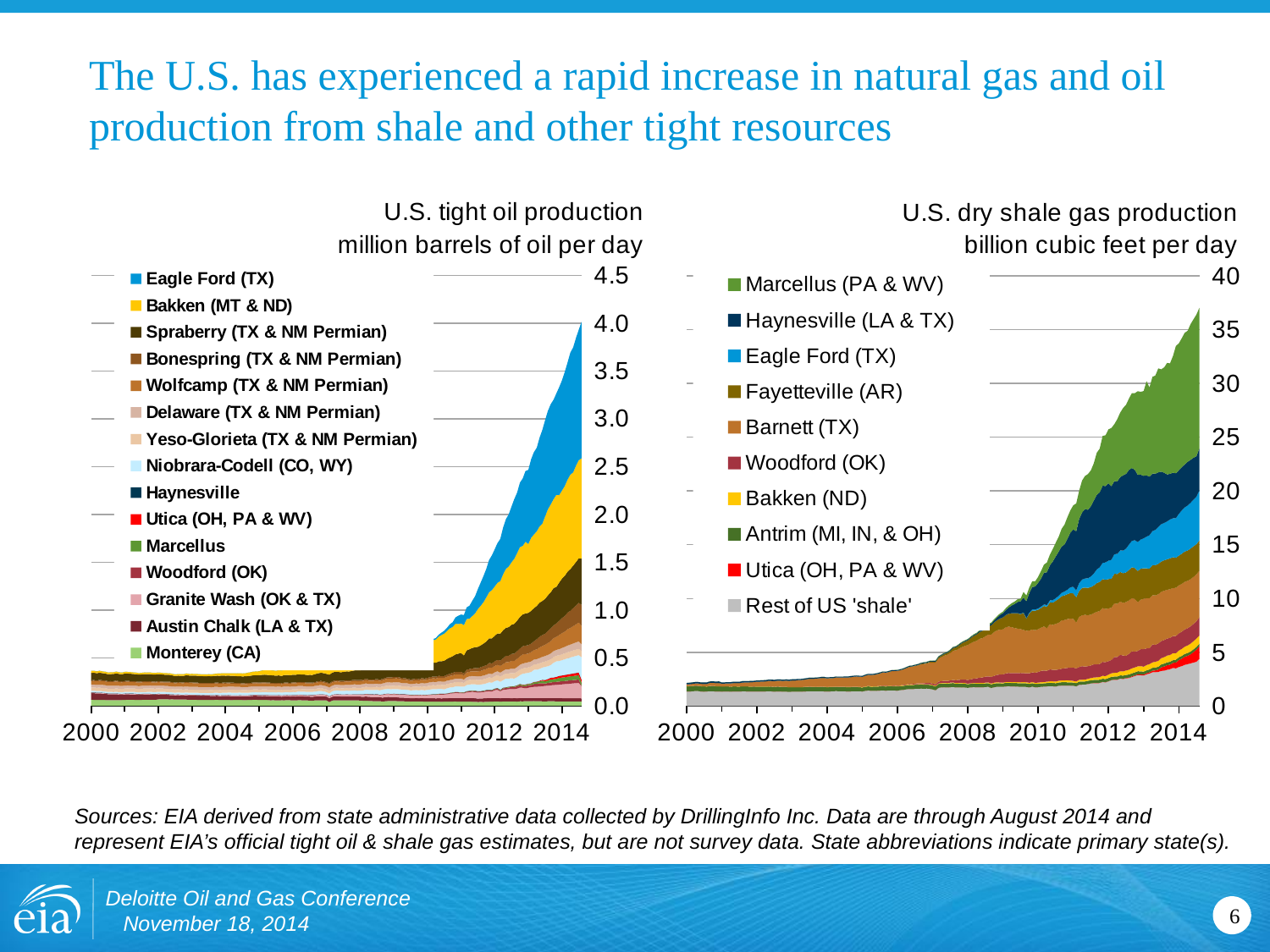
What is the highest value shown on the y axis of the U.S. tight oil production chart? 4.5 In the U.S. dry shale gas production chart, does total production rise or fall from 2000 to 2014? Rise How many series does the legend of the U.S. tight oil production chart list? 15 How many series does the legend of the U.S. dry shale gas production chart list? 10 What unit is used on the y axis of the U.S. dry shale gas production chart? billion cubic feet per day In the U.S. tight oil production chart, does total production rise or fall from 2010 to 2014? Rise In the U.S. dry shale gas production chart, is total production in 2006 greater or less than 10 billion cubic feet per day? less In the U.S. dry shale gas production chart, is total production in 2014 greater or less than 30 billion cubic feet per day? greater In the U.S. tight oil production chart, is total production in 2014 greater or less than 3.5 million barrels per day? greater What kind of chart is the U.S. dry shale gas production chart? Stacked area chart What kind of chart is the U.S. tight oil production chart? Stacked area chart